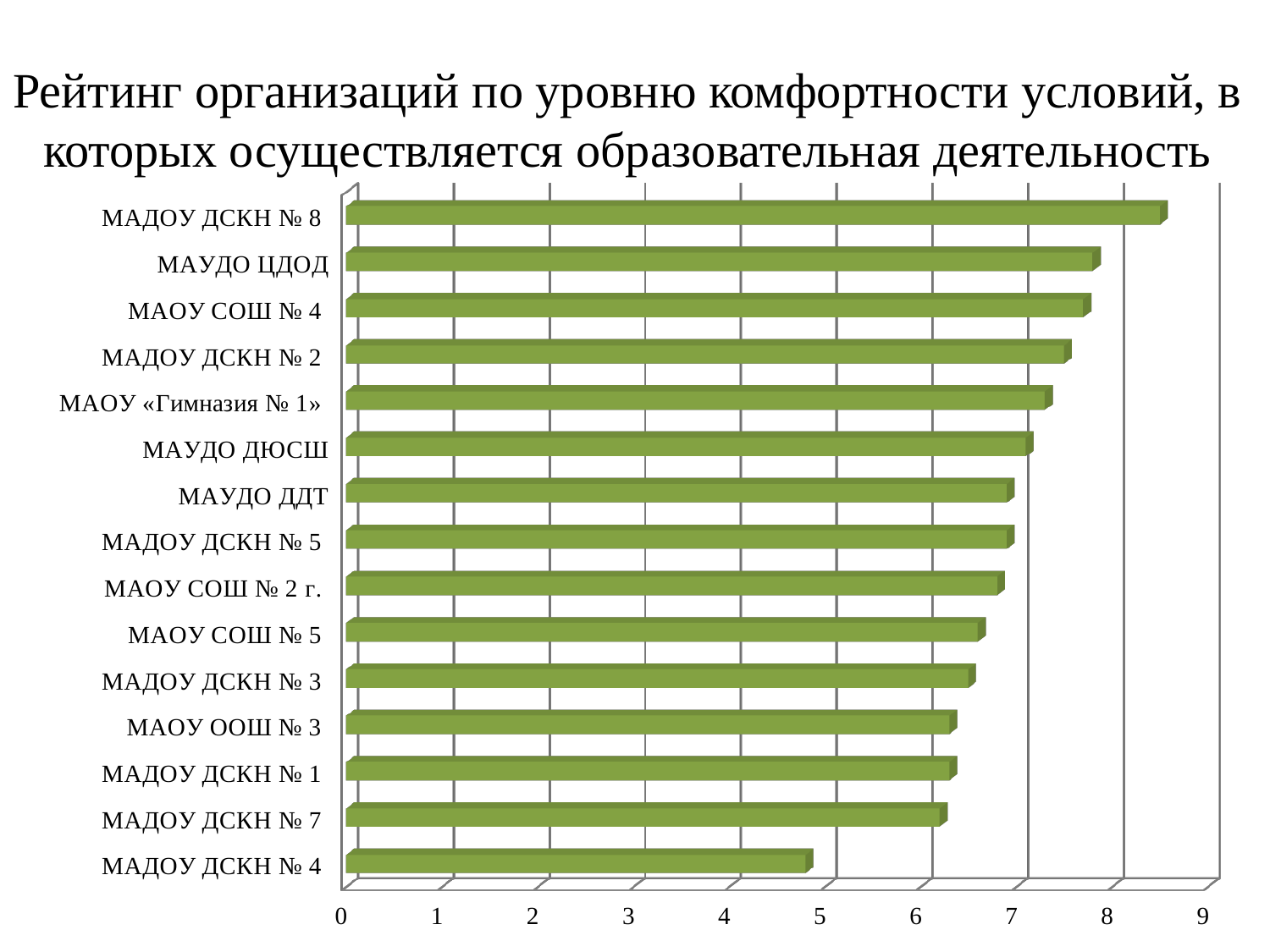
Which has the larger value, МАДОУ ДСКН № 4 or МАОУ СОШ № 4? МАОУ СОШ № 4 What kind of chart is shown on the slide? bar chart Is the value for МАУДО ЦДОД greater or less than 7? greater Is the value for МАДОУ ДСКН № 8 greater or less than 8? greater Which organisation has the lowest value in the chart? МАДОУ ДСКН № 4 How many organisations are listed in the chart? 15 What is the highest value shown on the horizontal axis of the chart? 9 Is the value for МАДОУ ДСКН № 4 greater or less than 5? less Which organisation has the highest value in the chart? МАДОУ ДСКН № 8 Which has the larger value, МАУДО ЦДОД or МАДОУ ДСКН № 7? МАУДО ЦДОД